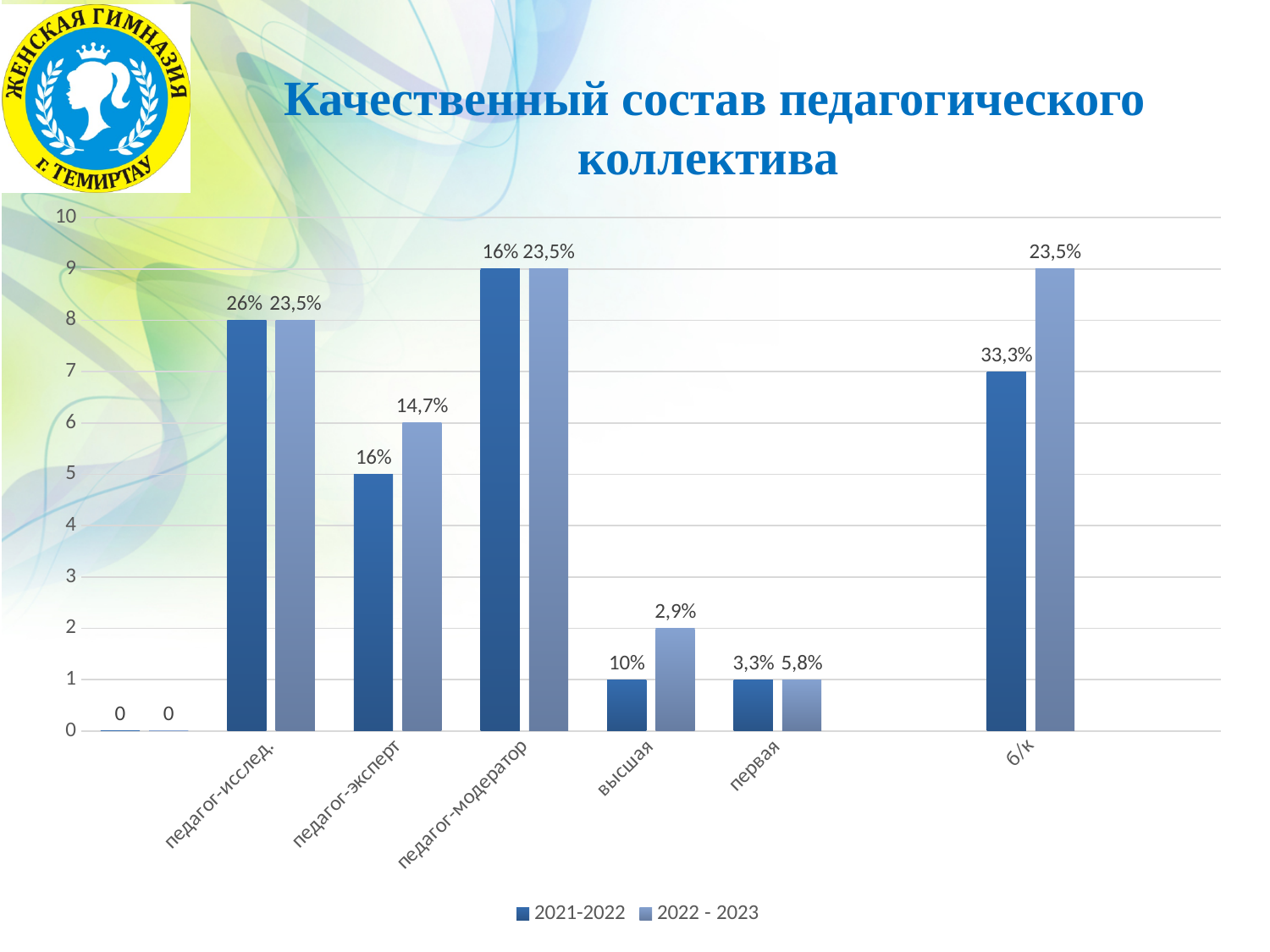
What are the two series named in the legend? 2021-2022 and 2022 - 2023 What data label is shown for the 2022 - 2023 series on высшая? 2,9% What kind of chart is shown on the slide? bar chart What is the title of the chart? Качественный состав педагогического коллектива For педагог-эксперт, which series has the larger data label, 2021-2022 or 2022 - 2023? 2021-2022 How many series does the legend list? 2 Which labelled category has the highest 2021-2022 data label? б/к What data label is shown for the 2021-2022 series on педагог-исслед.? 26% For б/к, what is the difference between the 2021-2022 label (33,3%) and the 2022 - 2023 label (23,5%)? 9,8% What data label is shown for the 2022 - 2023 series on педагог-эксперт? 14,7% What data label is shown for the 2021-2022 series on б/к? 33,3%